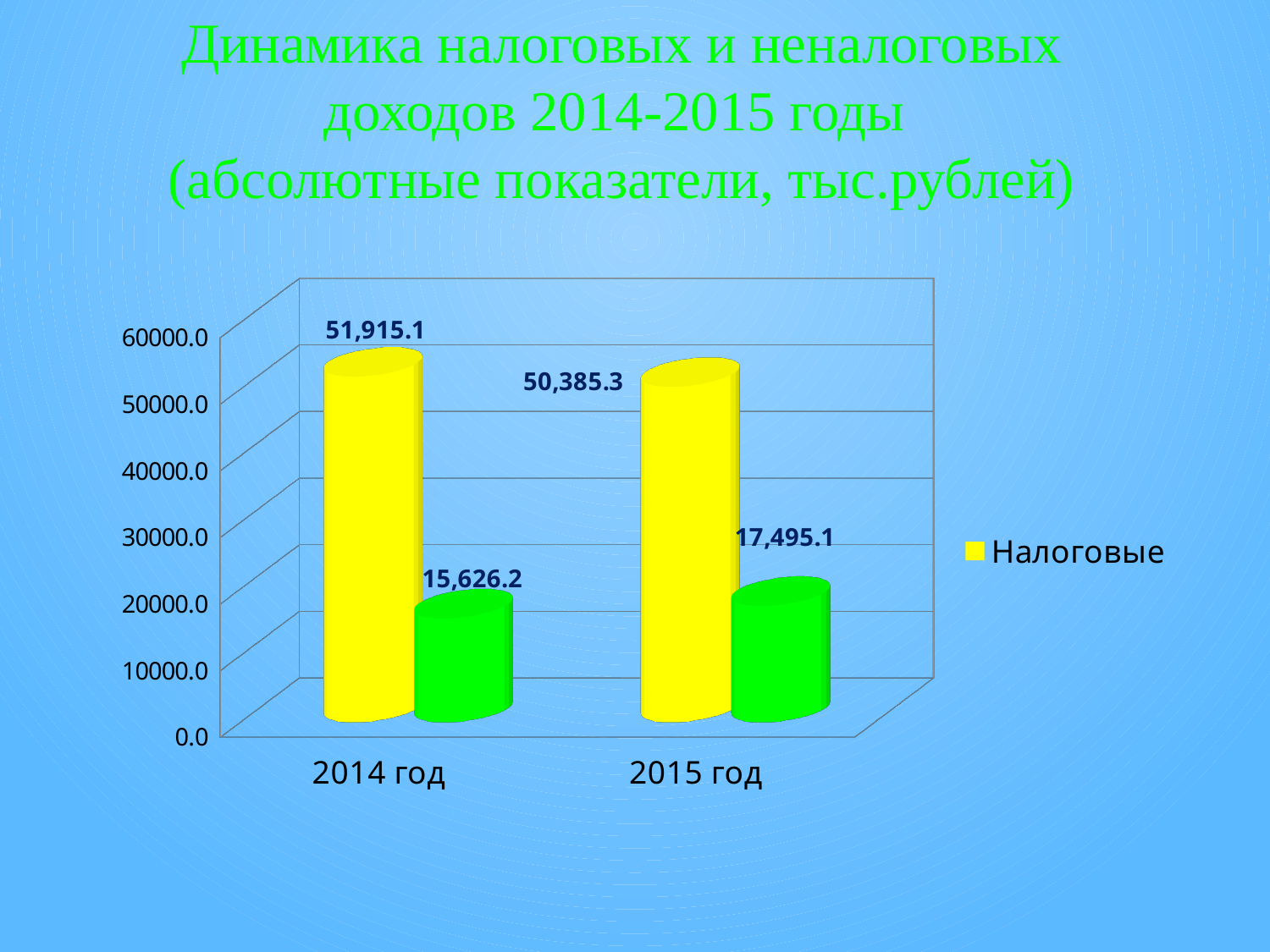
What is the value of the green bar for 2014 год? 15,626.2 What is the difference between the Налоговые values for 2014 год and 2015 год? 1,529.8 What kind of chart is shown on the slide? Bar chart Does the value of Налоговые rise or fall from 2014 год to 2015 год? Fall What is the value of Налоговые for 2014 год? 51,915.1 Which year has the lower value for the green series? 2014 год What is the value of the green bar for 2015 год? 17,495.1 Which year has the higher value for Налоговые? 2014 год How many year categories are shown on the x axis? 2 What is the difference between the green bar values for 2015 год and 2014 год? 1,868.9 Which is larger in 2015 год: the Налоговые bar or the green bar? Налоговые What is the value of Налоговые for 2015 год? 50,385.3